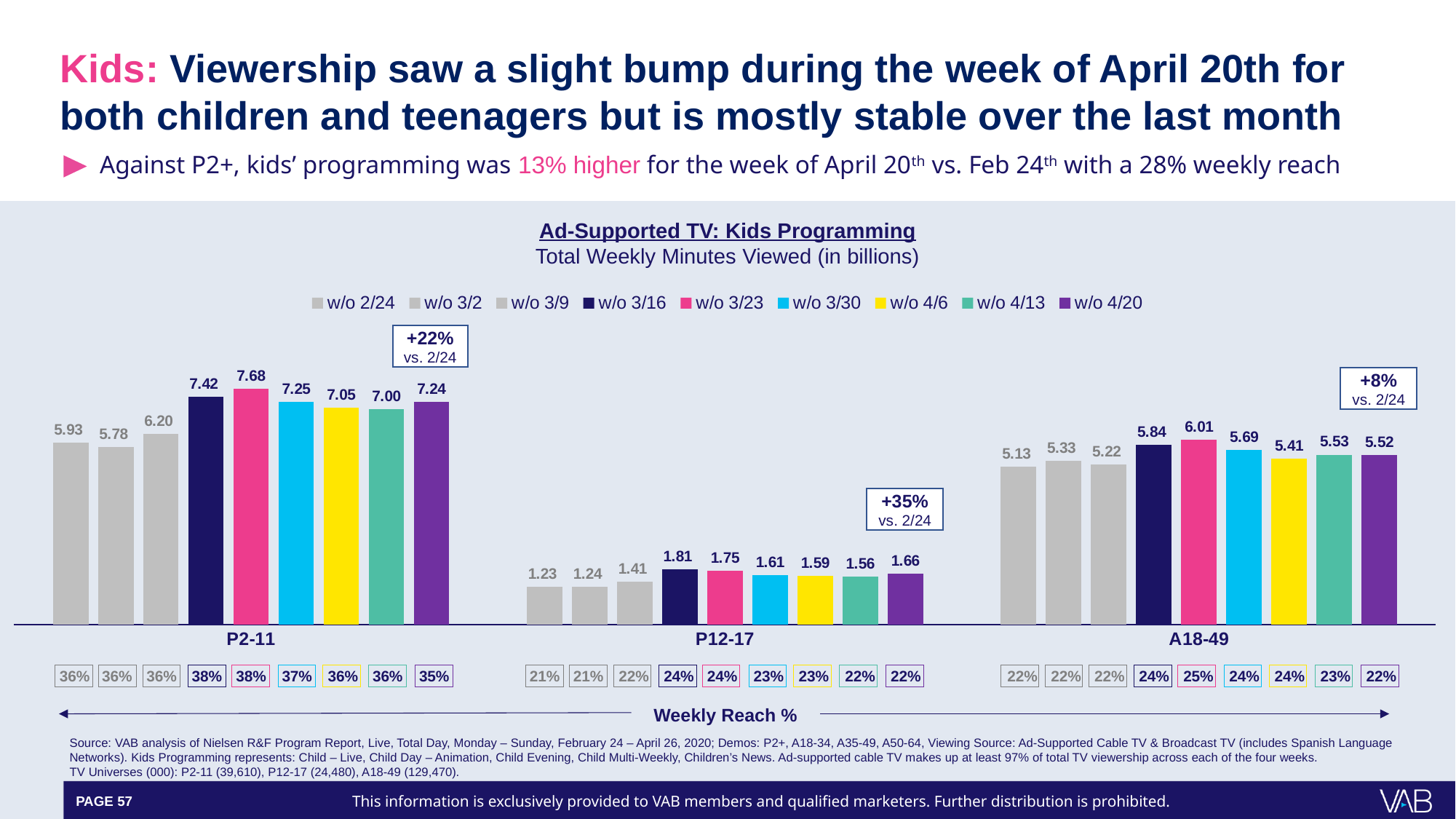
What is the value for P12-17 in the w/o 2/24 series? 1.23 Which week has the highest value for P2-11? w/o 3/23 What is the weekly reach % for P2-11 in the w/o 3/16 series? 38% What is the value for A18-49 in the w/o 3/23 series? 6.01 Which week has the lowest value for A18-49? w/o 2/24 Which is larger for A18-49: the w/o 3/16 value or the w/o 3/30 value? w/o 3/16 What is the value for P2-11 in the w/o 4/20 series? 7.24 How many series does the legend list? 9 How many demographic categories are shown on the x axis? 3 What kind of chart is shown on the slide? Bar chart What is the difference between the w/o 3/16 and w/o 2/24 values for P12-17? 0.58 What percentage change vs. 2/24 is annotated above the P12-17 group? +35%